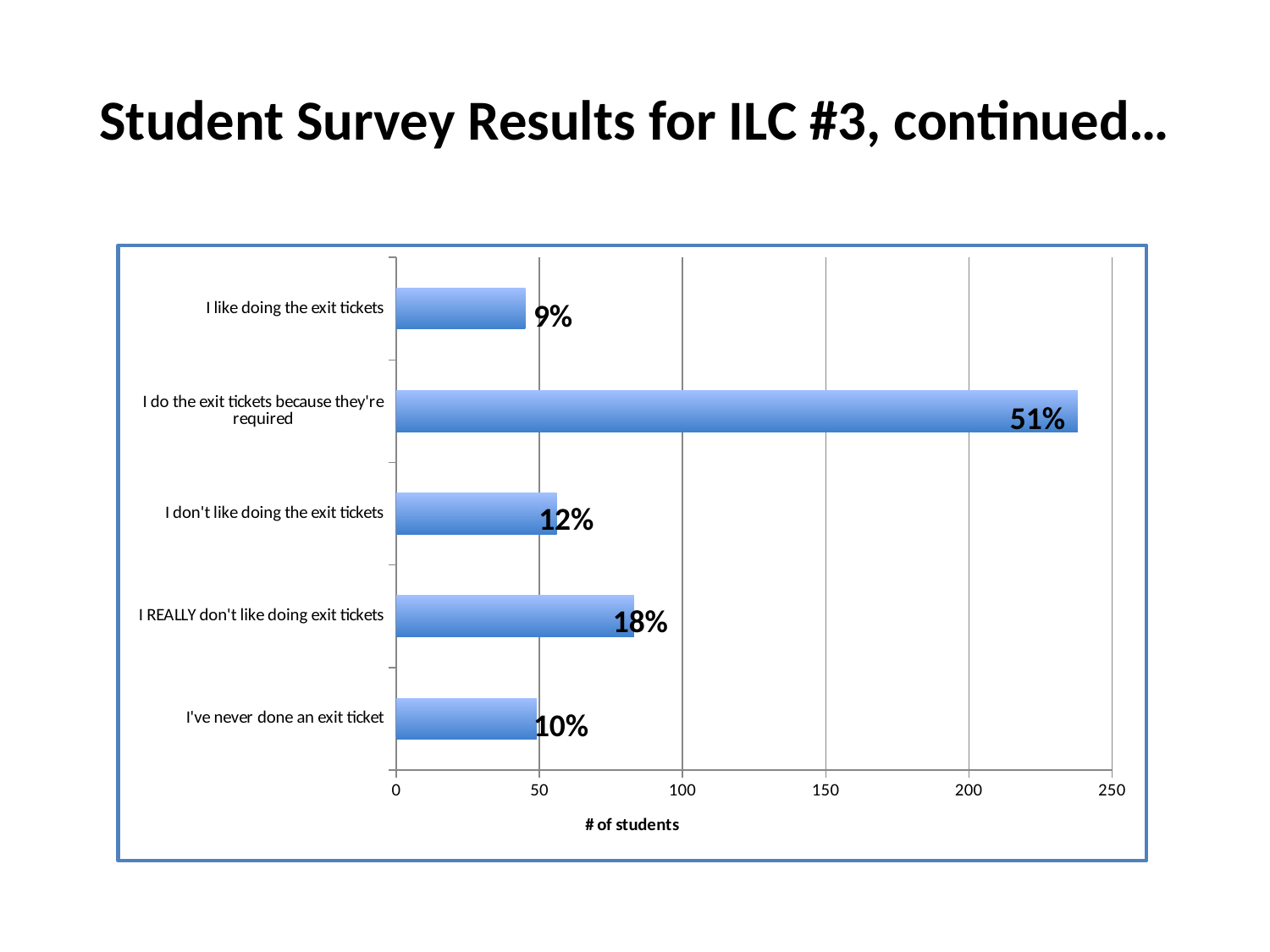
How many response categories are shown in the chart? 5 Which is larger: "I don't like doing the exit tickets" or "I REALLY don't like doing exit tickets"? I REALLY don't like doing exit tickets What type of chart is shown on the slide? Bar chart What percentage label is shown for "I like doing the exit tickets"? 9% What percentage label is shown for "I REALLY don't like doing exit tickets"? 18% What percentage label is shown for "I've never done an exit ticket"? 10% By how many percentage points does "I do the exit tickets because they're required" exceed "I REALLY don't like doing exit tickets"? 33 percentage points What percentage label is shown for "I do the exit tickets because they're required"? 51% Which response has the highest value? I do the exit tickets because they're required Which response has the lowest value? I like doing the exit tickets Is the number of students for "I do the exit tickets because they're required" greater or less than 200? greater Is the number of students for "I REALLY don't like doing exit tickets" greater or less than 100? less